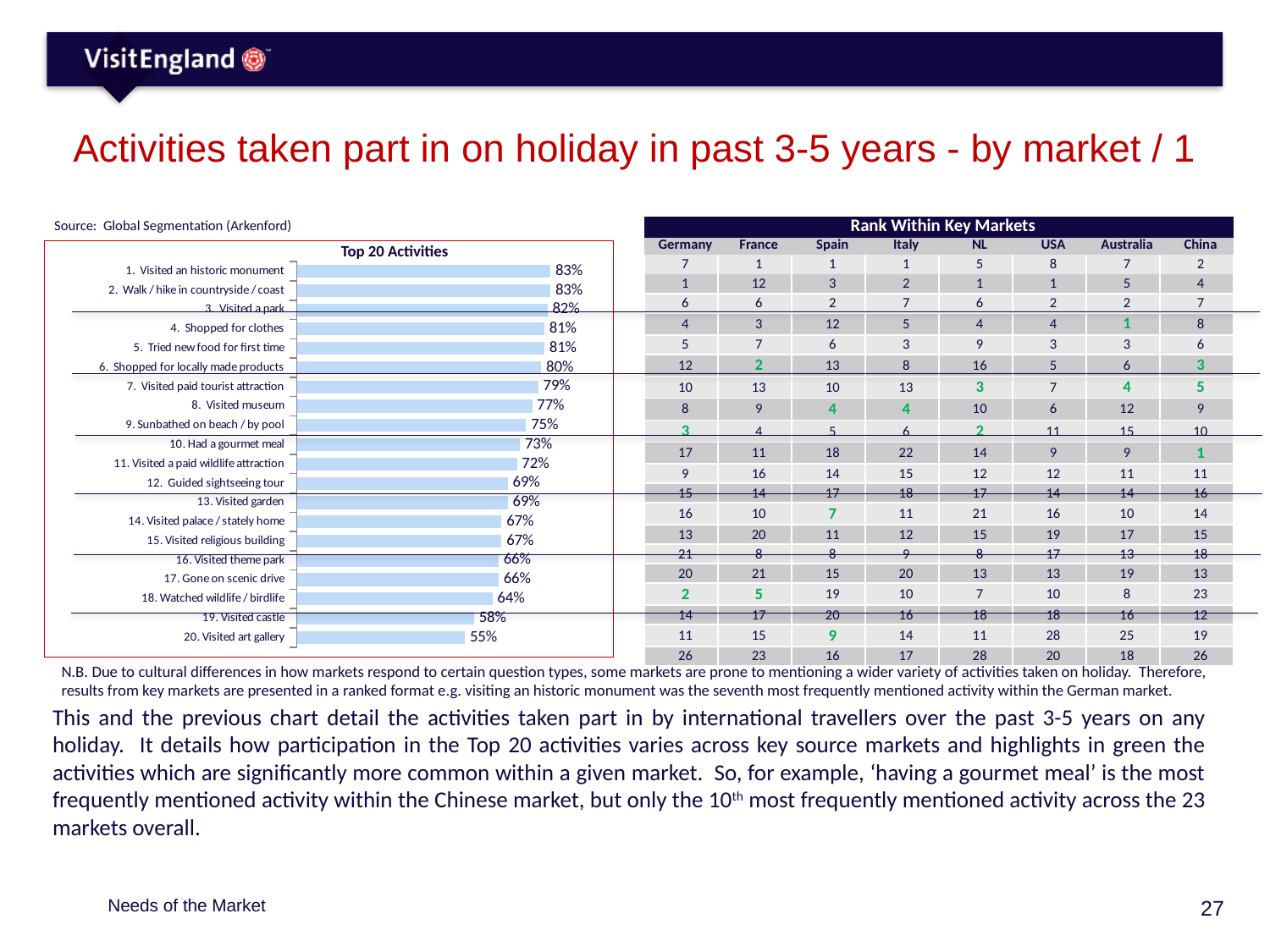
What is the value for 'Visited castle' in the Top 20 Activities chart? 58% What kind of chart is the Top 20 Activities chart? Bar chart Which has a larger value in the Top 20 Activities chart: 'Visited a park' or 'Visited theme park'? Visited a park Which activity has the lowest value in the Top 20 Activities chart? Visited art gallery Which has a larger value in the Top 20 Activities chart: 'Visited castle' or 'Guided sightseeing tour'? Guided sightseeing tour How many activities are plotted in the Top 20 Activities chart? 20 What is the value for 'Had a gourmet meal' in the Top 20 Activities chart? 73% What is the value for 'Sunbathed on beach / by pool' in the Top 20 Activities chart? 75% What is the value for 'Visited museum' in the Top 20 Activities chart? 77% What is the difference between the values for 'Visited paid tourist attraction' and 'Watched wildlife / birdlife' in the Top 20 Activities chart? 15% What is the difference between the values for 'Visited an historic monument' and 'Visited art gallery' in the Top 20 Activities chart? 28% Do the values in the Top 20 Activities chart rise or fall going from activity 1 down to activity 20? Fall